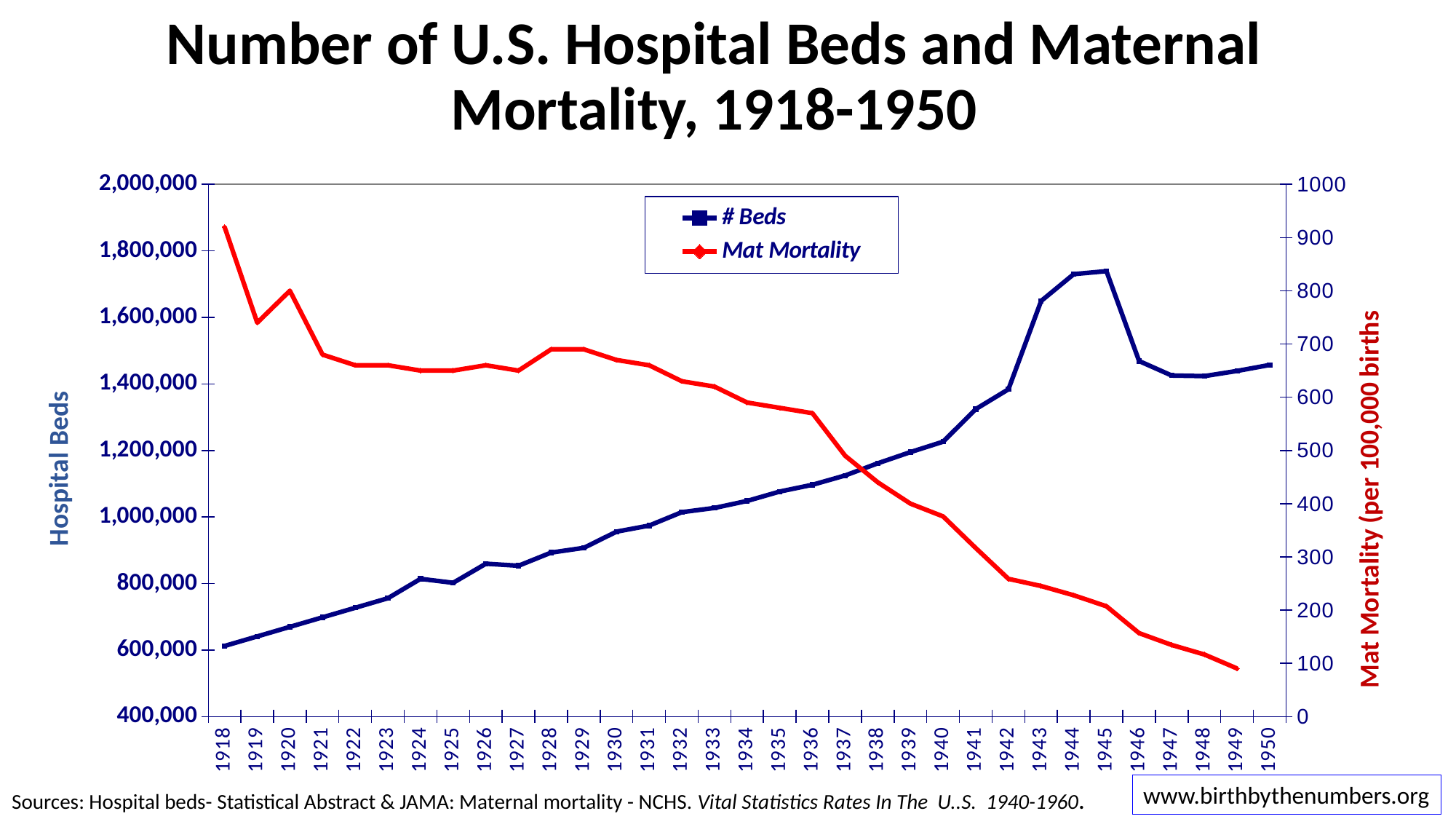
What is the label of the left vertical axis? Hospital Beds Is the value for # Beds in 1944 greater or less than 1,600,000? greater What are the two series named in the legend? # Beds and Mat Mortality Is the value for # Beds in 1918 greater or less than 800,000? less Is the value for Mat Mortality in 1949 greater or less than 200? less How many series does the legend list? 2 Does the Mat Mortality line rise or fall overall from 1918 to 1949? fall Does the # Beds line rise or fall overall from 1918 to 1950? rise In which year is Mat Mortality at its highest? 1918 What kind of chart is shown on the slide? line chart In which year is the number of hospital beds (# Beds) at its lowest? 1918 Which year has the higher Mat Mortality value, 1920 or 1921? 1920